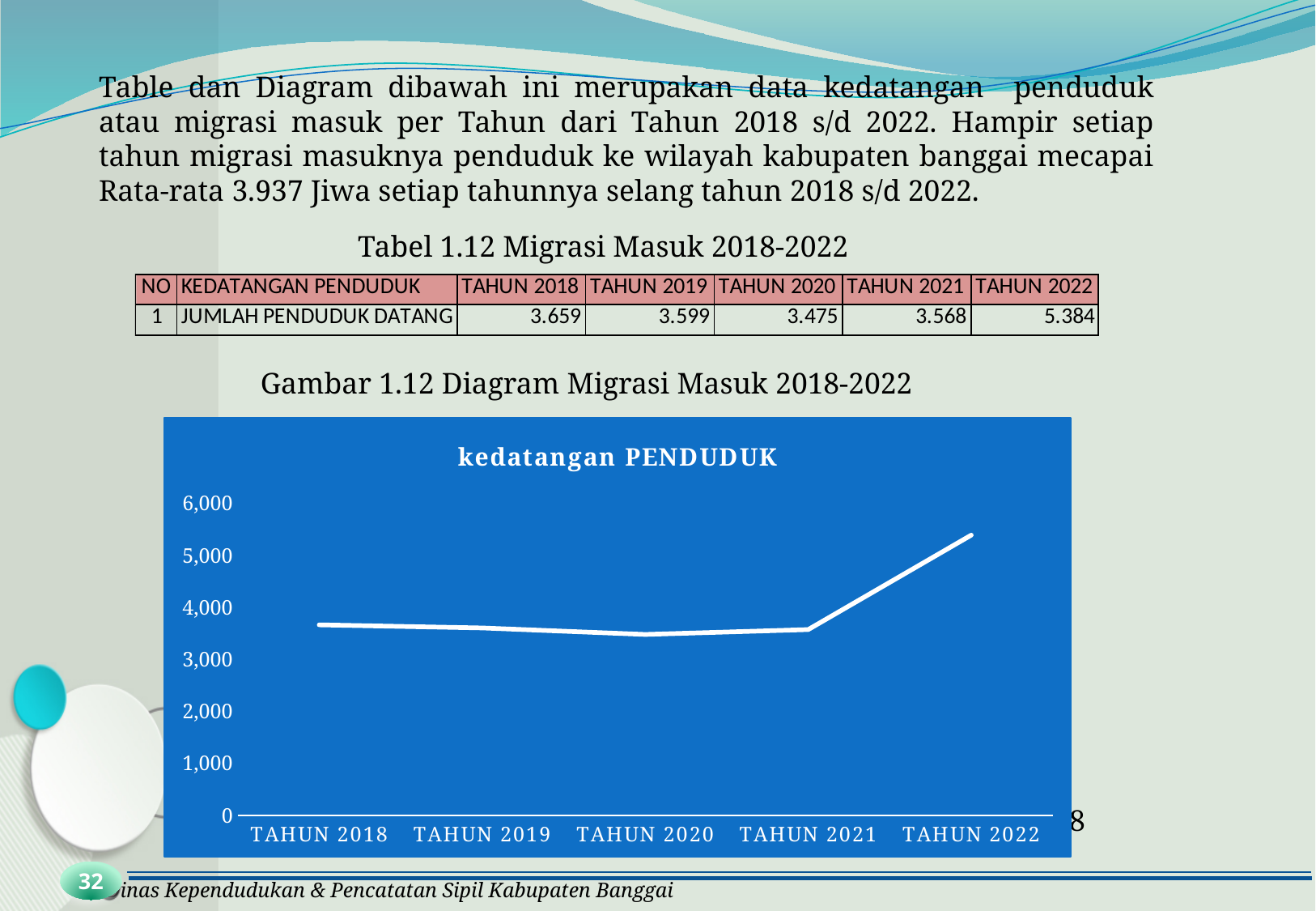
Is the value for TAHUN 2022 greater or less than 5,000? greater What is the value for TAHUN 2018? 3.659 How many years (points) are plotted on the x axis of the chart? 5 Does the line rise or fall from TAHUN 2021 to TAHUN 2022? rise Which year has the lowest value in the chart? TAHUN 2020 What is the value for TAHUN 2020? 3.475 What is the value for TAHUN 2022? 5.384 What is the title of the chart? kedatangan PENDUDUK Is the value for TAHUN 2020 greater or less than 4,000? less Which is larger, the value for TAHUN 2022 or the value for TAHUN 2021? TAHUN 2022 Which year has the highest value in the chart? TAHUN 2022 What type of chart is shown under 'Gambar 1.12 Diagram Migrasi Masuk 2018-2022'? line chart